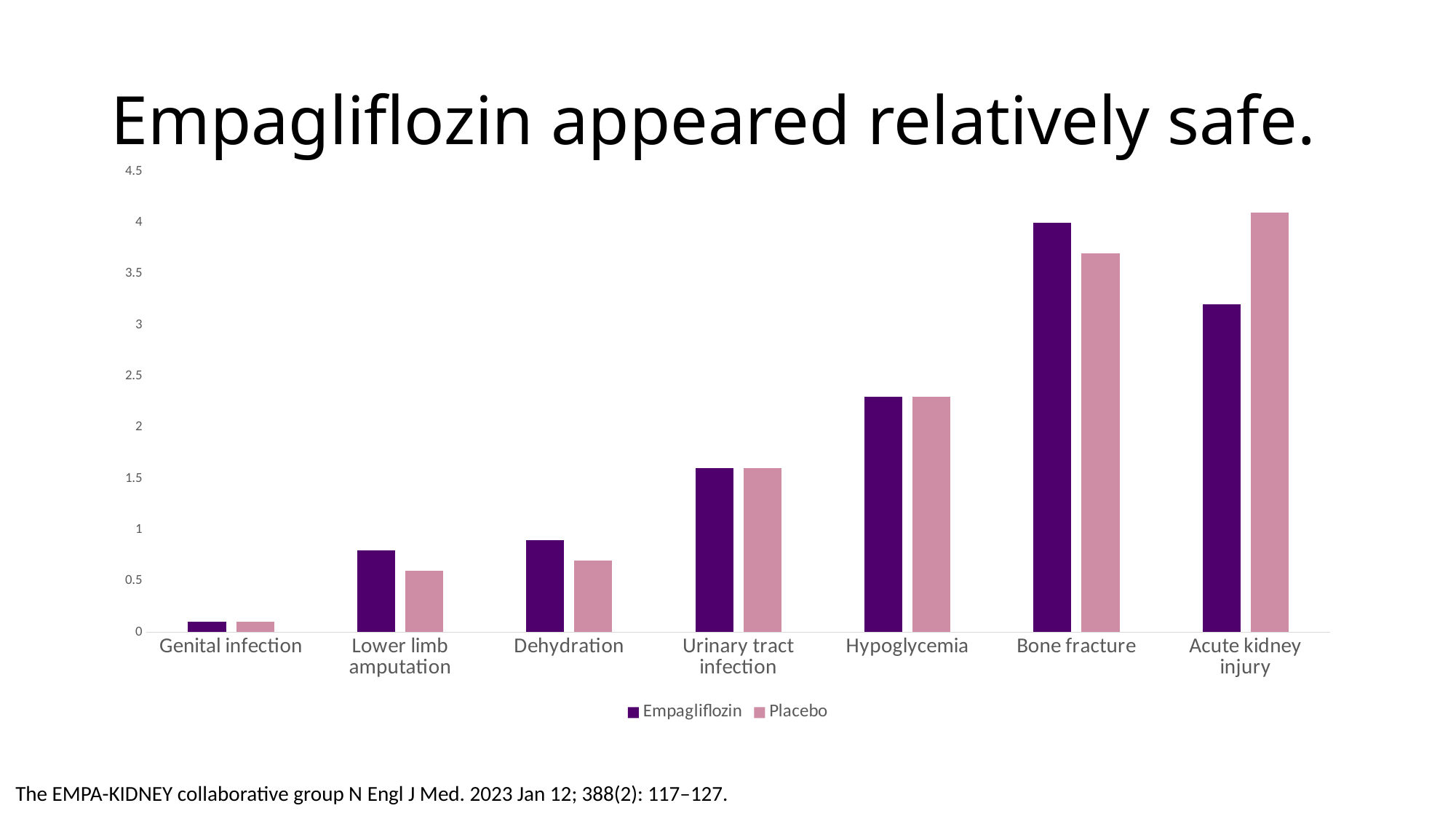
Is the Empagliflozin value for Acute kidney injury greater or less than 3? greater Which category has the highest Empagliflozin bar? Bone fracture How many adverse event categories are shown on the x axis? 7 Is the Empagliflozin value for Hypoglycemia greater or less than 2? greater For Acute kidney injury, which is larger: the Empagliflozin bar or the Placebo bar? Placebo Which category has the lowest bars for both Empagliflozin and Placebo? Genital infection How many series does the legend list? 2 Which category has the highest Placebo bar? Acute kidney injury For Bone fracture, which is larger: the Empagliflozin bar or the Placebo bar? Empagliflozin Is the Placebo value for Dehydration greater or less than 1? less What is the title of the slide? Empagliflozin appeared relatively safe. What kind of chart is shown on the slide? bar chart